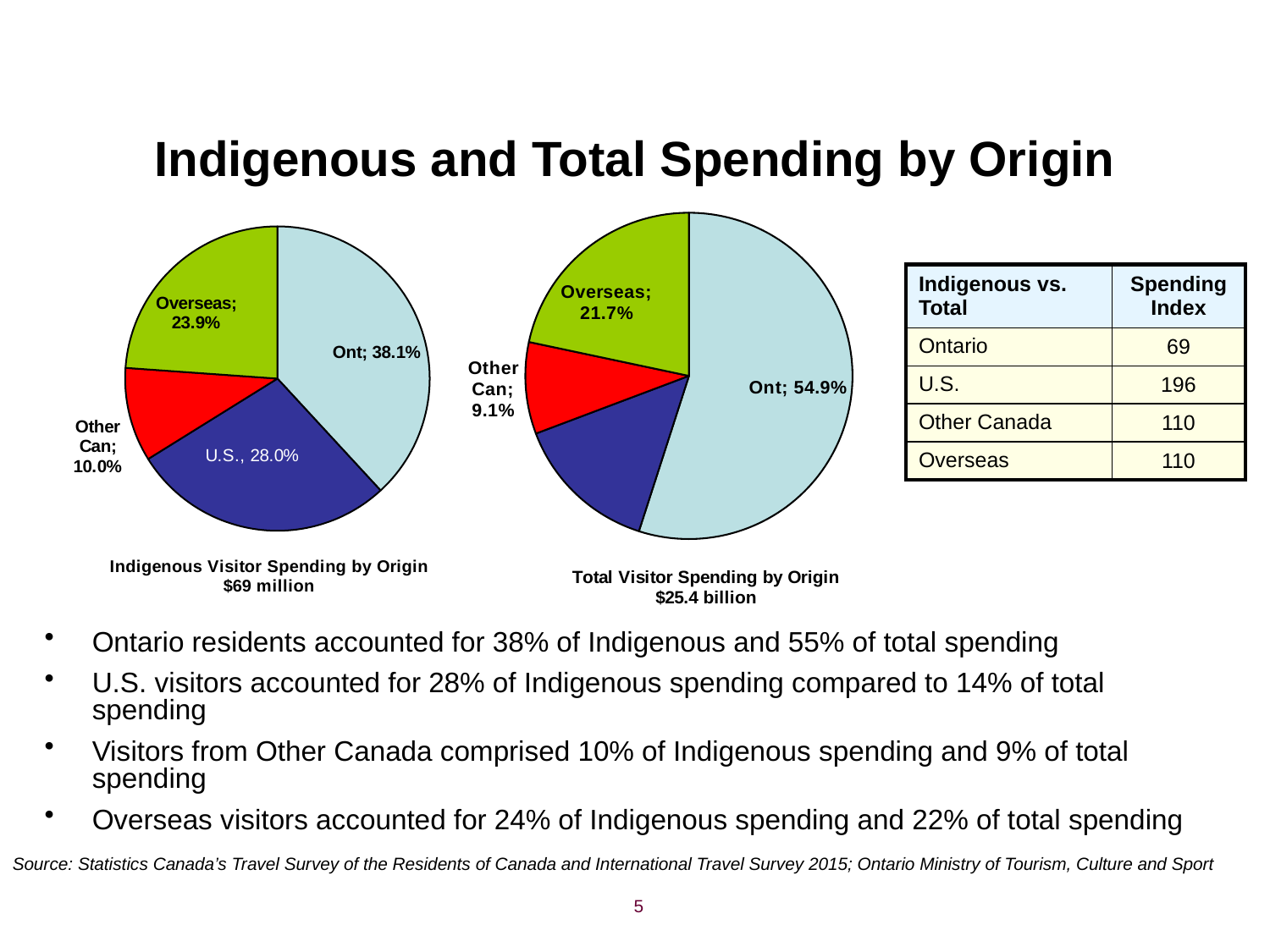
In the Total Visitor Spending by Origin chart, what share of spending comes from Other Canada? 9.1% In the Indigenous Visitor Spending by Origin chart, what share of spending comes from Overseas? 23.9% In the Total Visitor Spending by Origin chart, which origin has the largest share? Ont What total amount is shown beneath the Indigenous Visitor Spending by Origin chart? $69 million In the Indigenous Visitor Spending by Origin chart, what share of spending comes from the U.S.? 28.0% In the Indigenous Visitor Spending by Origin chart, which is larger, the Overseas share or the Other Can share? Overseas How many slices does the Indigenous Visitor Spending by Origin chart have? 4 In the Indigenous Visitor Spending by Origin chart, what is the difference between the Ontario share and the U.S. share? 10.1% In the Indigenous Visitor Spending by Origin chart, which origin has the smallest share? Other Can What type of chart is the Total Visitor Spending by Origin chart? Pie chart In the Indigenous Visitor Spending by Origin chart, what share of spending comes from Ontario? 38.1% In the Total Visitor Spending by Origin chart, what share of spending comes from Ontario? 54.9%